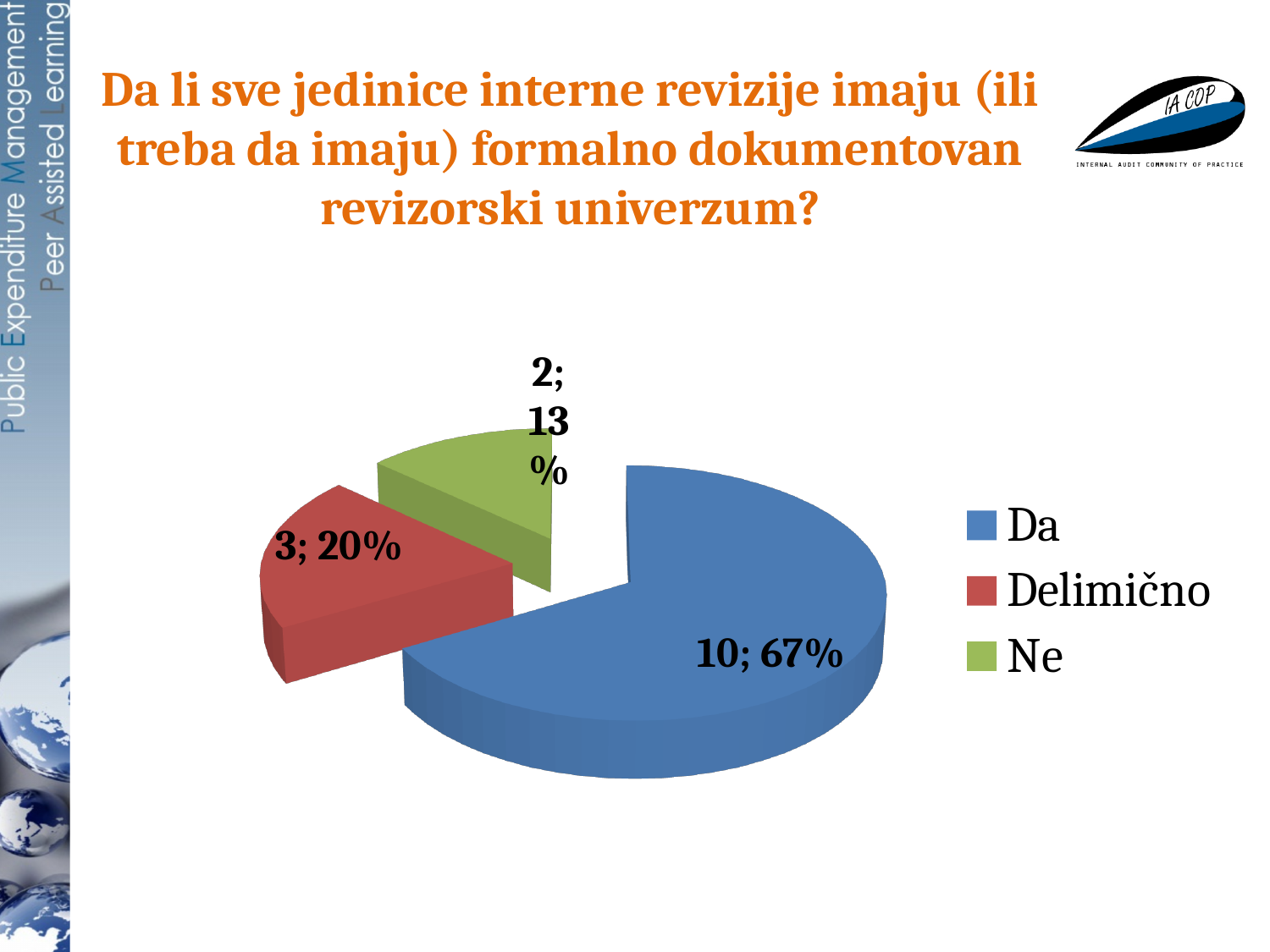
What is the count for the "Delimično" slice? 3 What kind of chart is shown on the slide? pie chart What is the difference in count between "Da" and "Delimično"? 7 What percentage share does the "Da" slice have? 67% What percentage share does the "Ne" slice have? 13% Which category has the smallest slice? Ne What is the count for the "Da" slice? 10 Which category has the largest slice? Da Which colour represents the "Ne" category in the legend? green What percentage share does the "Delimično" slice have? 20% What is the count for the "Ne" slice? 2 How many categories does the pie chart have? 3